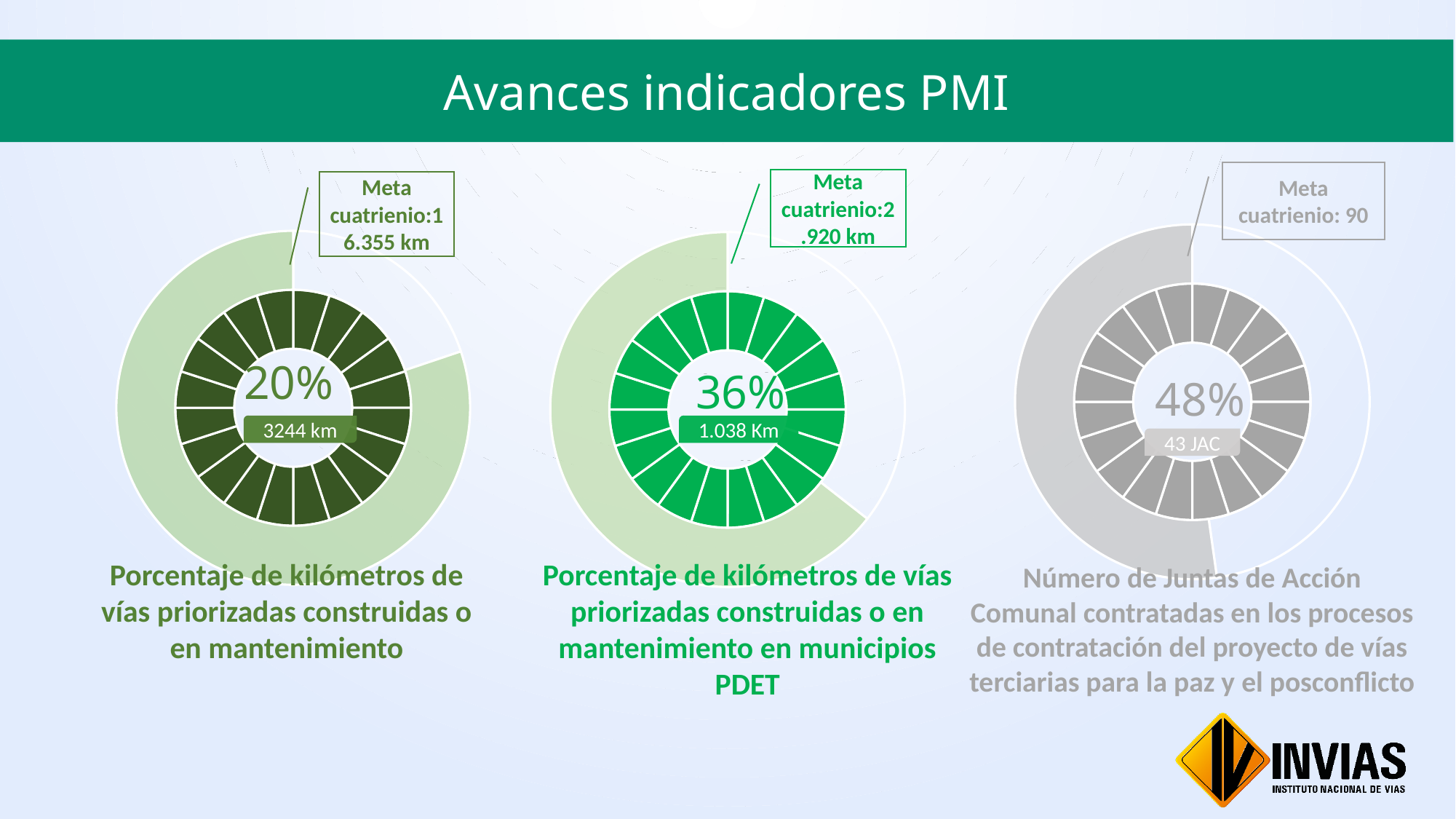
On the right chart, how many JAC are reported as contracted? 43 JAC Which of the three charts shows the lowest percentage of progress? Porcentaje de kilómetros de vías priorizadas construidas o en mantenimiento (20%) Which of the three charts shows the highest percentage of progress? Número de Juntas de Acción Comunal contratadas (48%) What is the difference in percentage points between the right chart (48%) and the left chart (20%)? 28 percentage points On the left chart (Porcentaje de kilómetros de vías priorizadas construidas o en mantenimiento), what percentage is shown in the centre? 20% On the right chart (Número de Juntas de Acción Comunal contratadas), what percentage is shown in the centre? 48% On the middle chart (municipios PDET), what percentage is shown in the centre? 36% On the middle chart, how many kilometres are reported as achieved? 1.038 Km Is the percentage on the middle chart larger or smaller than the percentage on the right chart? smaller On the left chart, how many kilometres are reported as achieved? 3244 km How many gauge charts are shown on the slide? 3 What is the 'Meta cuatrienio' shown for the right chart? 90